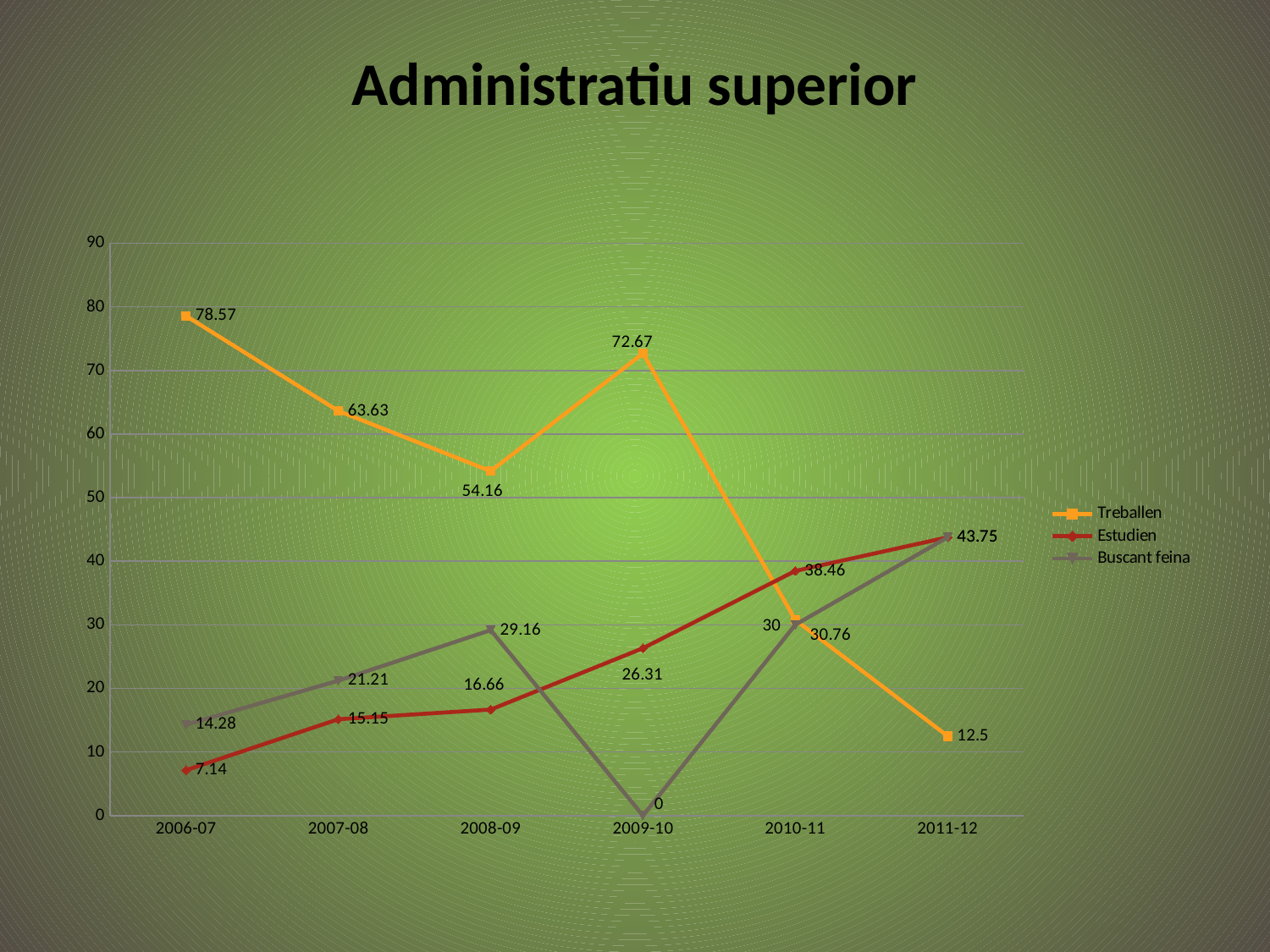
In which year is the Treballen series lowest? 2011-12 In 2010-11, which is larger: Estudien or Treballen? Estudien What is the value for Buscant feina in 2009-10? 0 Is the value for Treballen in 2009-10 greater or less than 70? greater What is the value for Estudien in 2009-10? 26.31 What is the difference between the Treballen values for 2006-07 and 2007-08? 14.94 What is the value for Treballen in 2006-07? 78.57 Does the Estudien series rise or fall from 2006-07 to 2011-12? rise What kind of chart is shown on the slide? line chart How many series does the legend list? 3 In which year is the Treballen series highest? 2006-07 How many academic years are shown on the x axis? 6